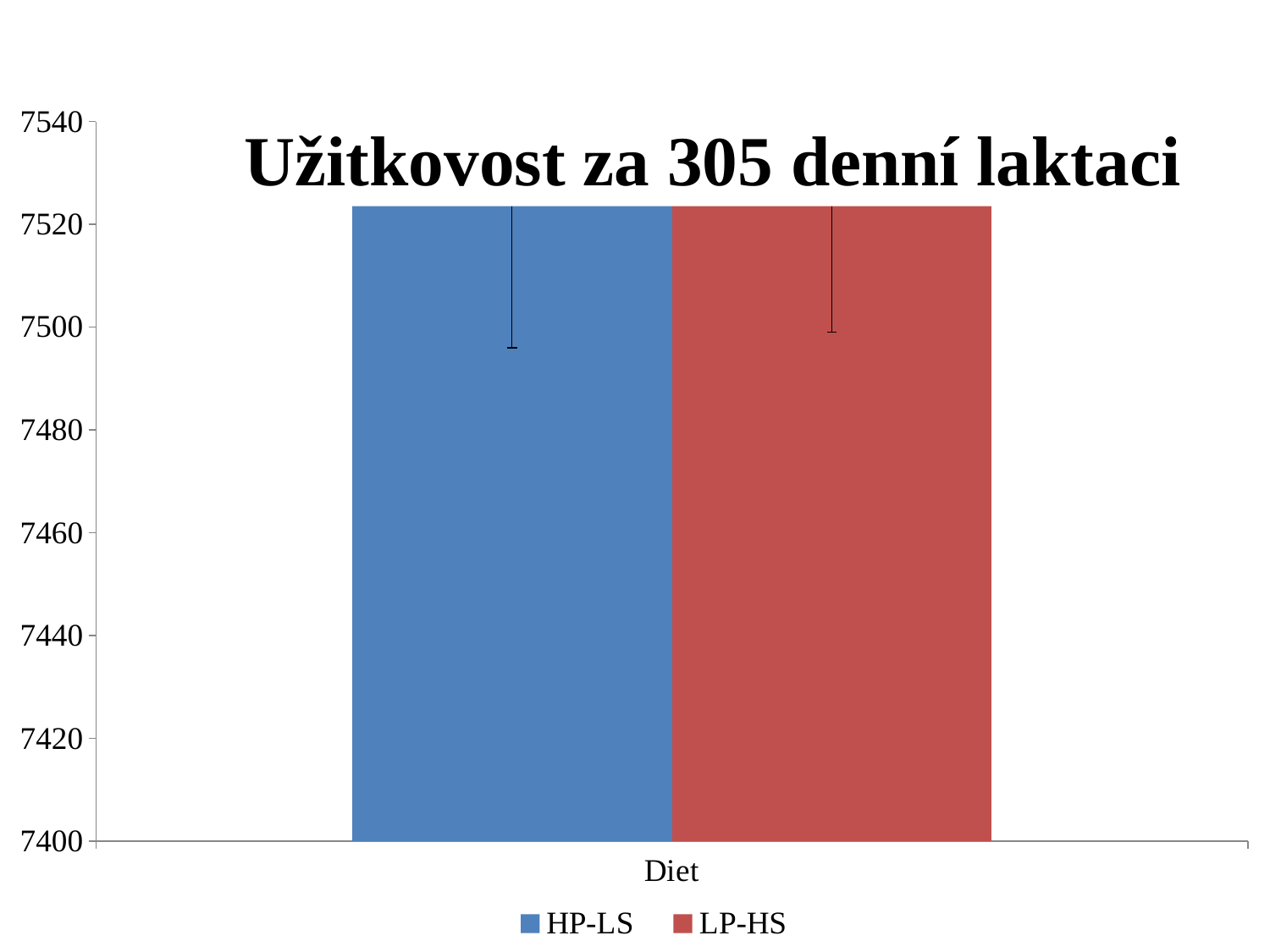
Is the value for LP-HS greater or less than 7540? less What kind of chart is shown on the slide? bar chart What is the title of the chart? Užitkovost za 305 denní laktaci What are the two series named in the legend? HP-LS and LP-HS What is the highest value shown on the y axis? 7540 What is the lowest value shown on the y axis? 7400 Is the value for LP-HS greater or less than 7500? greater How many categories are shown on the x axis? 1 Is the value for HP-LS greater or less than 7540? less What is the label of the category on the x axis? Diet How many series does the legend list? 2